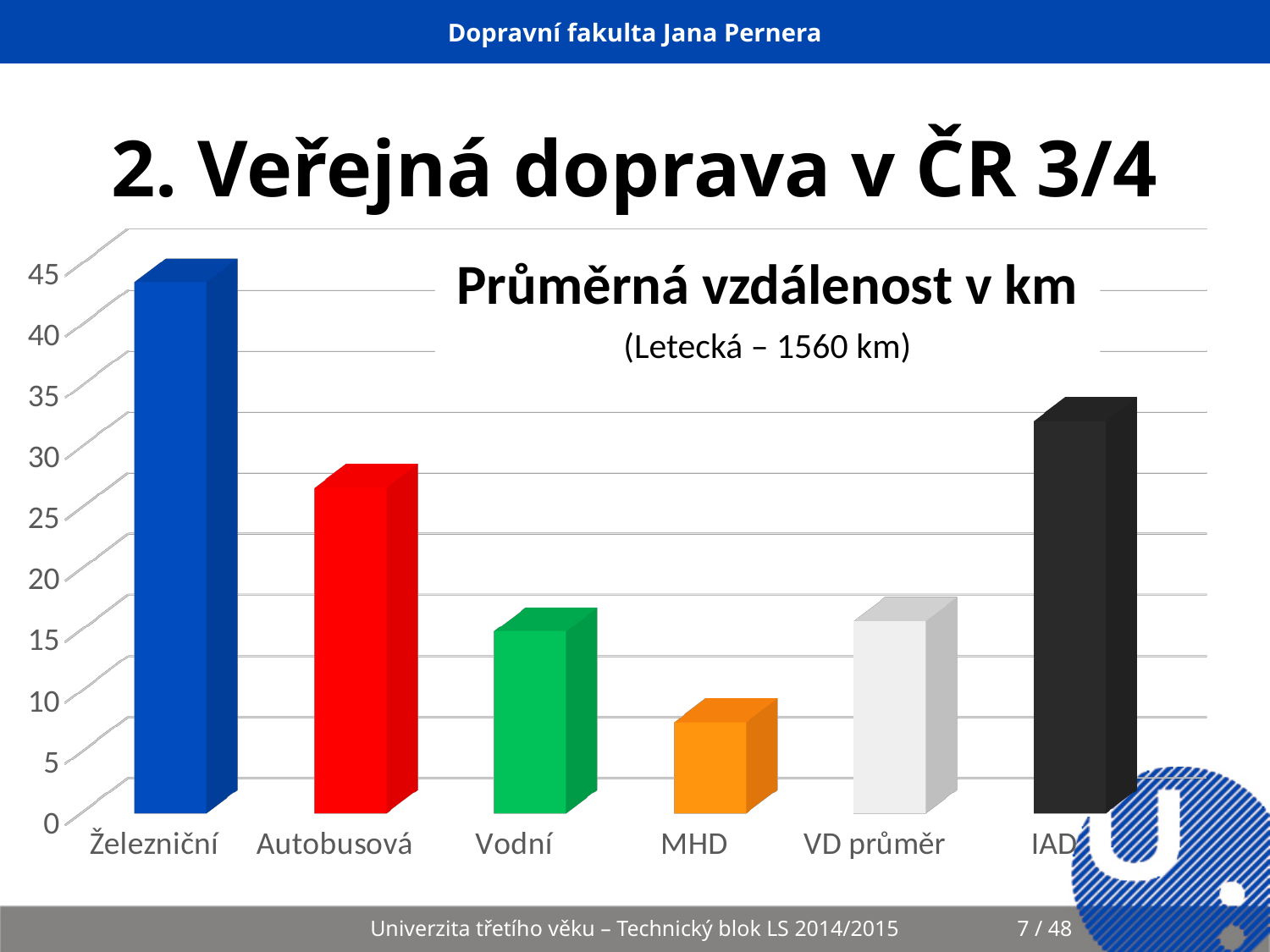
Is the value for Železniční greater or less than 40? greater Which category has the lowest value in the chart? MHD Is the value for MHD greater or less than 10? less What value is given in the chart subtitle for Letecká? 1560 km How many categories are shown on the x axis of the chart? 6 Which has a larger value, IAD or Autobusová? IAD Is the value for Autobusová greater or less than 25? greater Which has a larger value, Autobusová or Vodní? Autobusová What is the title of the chart? Průměrná vzdálenost v km What kind of chart is shown on the slide? bar chart Which category has the highest value in the chart? Železniční